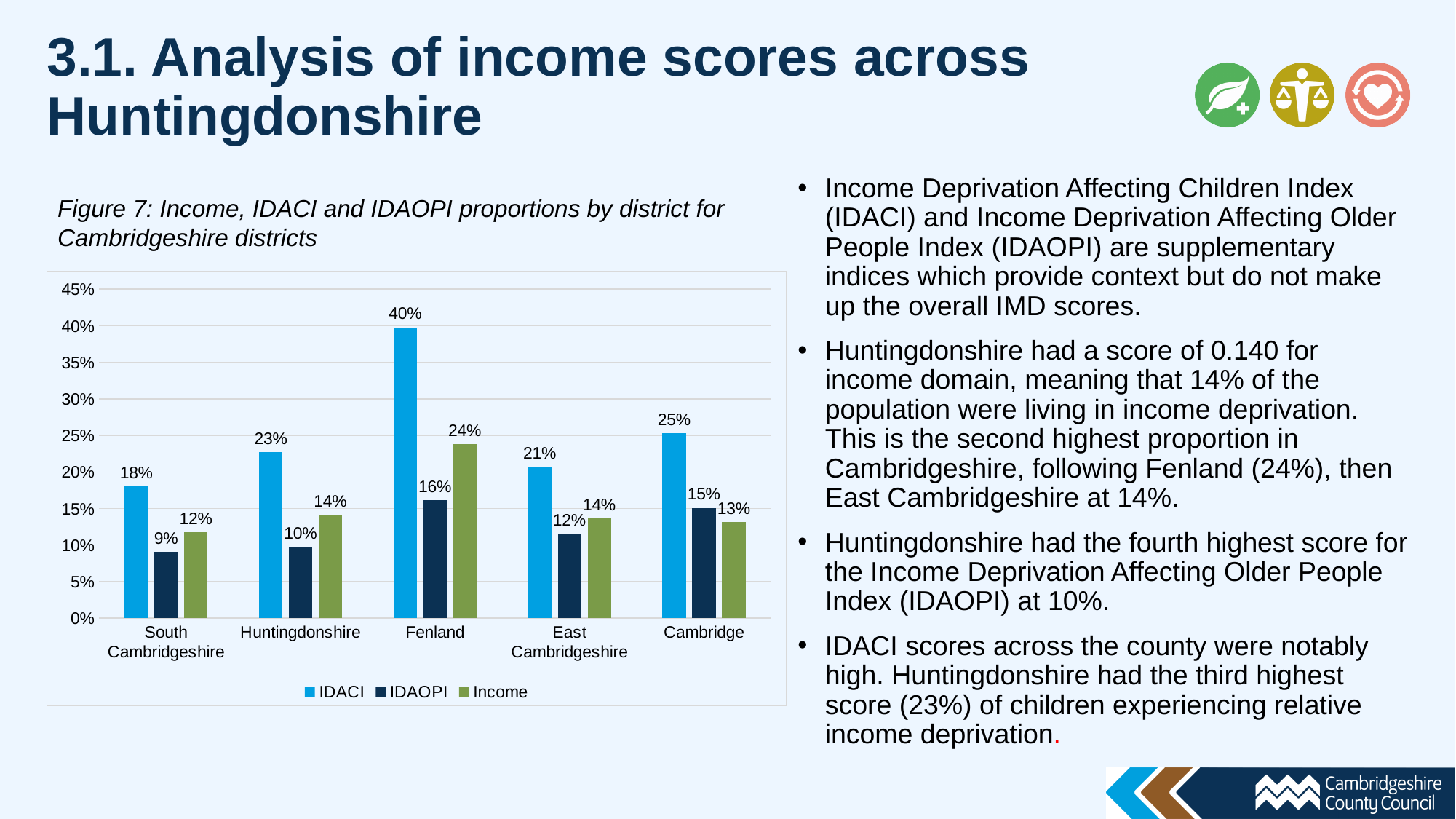
What is the IDACI value for Fenland? 40% Which district has the highest IDACI value? Fenland What is the difference between the IDACI values for Fenland and Cambridge? 15% How many districts are shown on the x axis? 5 Is the IDACI value for Huntingdonshire greater or less than 20%? greater What kind of chart is shown? bar chart What is the IDAOPI value for Cambridge? 15% What is the figure caption above the chart? Figure 7: Income, IDACI and IDAOPI proportions by district for Cambridgeshire districts Which district has the lowest IDAOPI value? South Cambridgeshire What is the Income value for Huntingdonshire? 14% Which is larger, the Income value for Fenland or the Income value for Cambridge? Fenland How many series does the legend list? 3